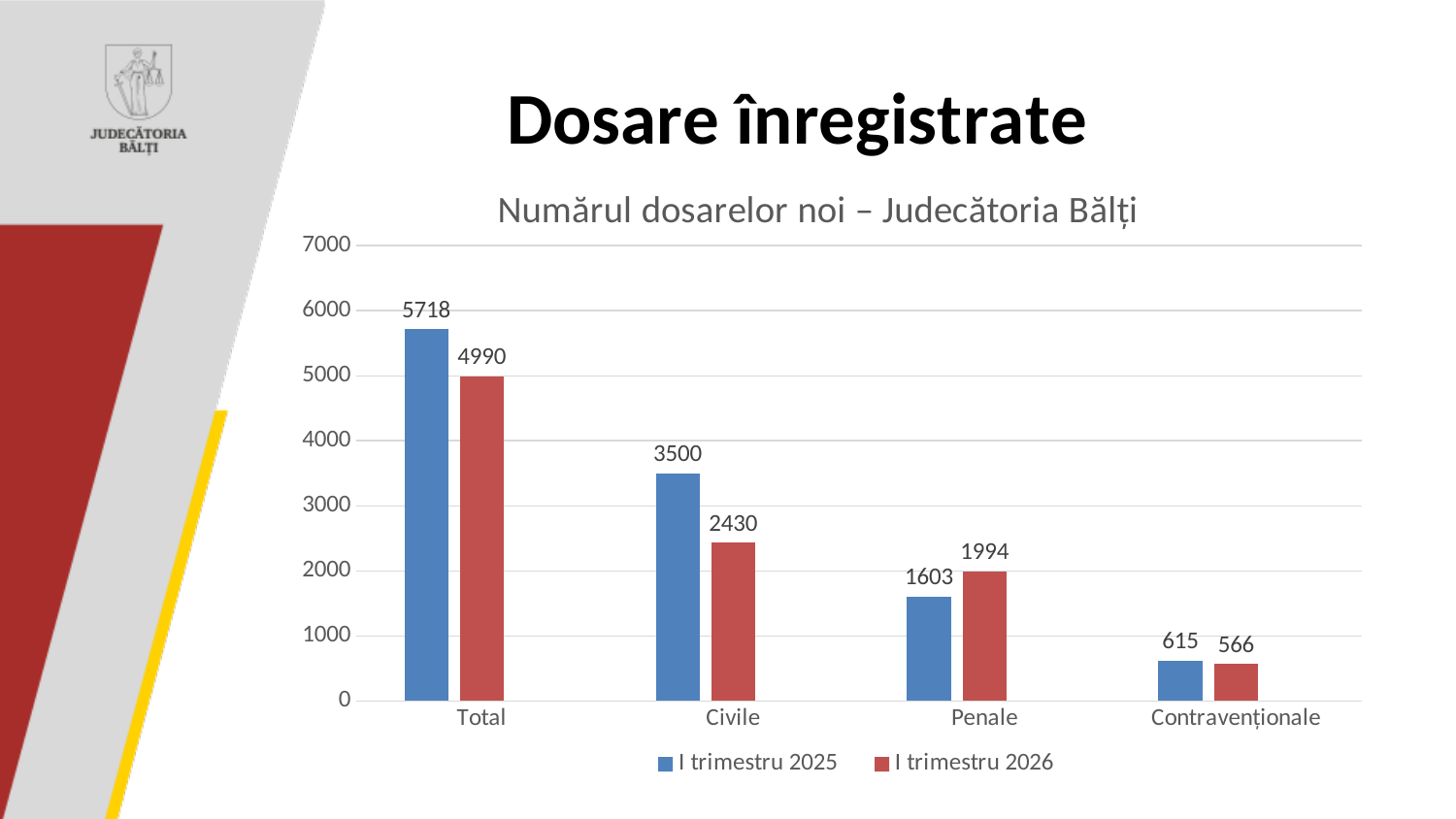
What is the difference between the I trimestru 2025 and I trimestru 2026 values for Total? 728 What is the difference between the I trimestru 2025 and I trimestru 2026 values for Civile? 1070 How many categories are shown on the x axis? 4 Which category has the highest value in the I trimestru 2025 series? Total How many series does the legend list? 2 What is the value for Civile in the I trimestru 2025 series? 3500 What is the title of the chart? Numărul dosarelor noi – Judecătoria Bălți What is the value for Penale in the I trimestru 2026 series? 1994 What kind of chart is shown on the slide? Bar chart What is the value for Contravenționale in the I trimestru 2025 series? 615 Which category has the lowest value in the I trimestru 2026 series? Contravenționale For Penale, which series has the larger value: I trimestru 2025 or I trimestru 2026? I trimestru 2026